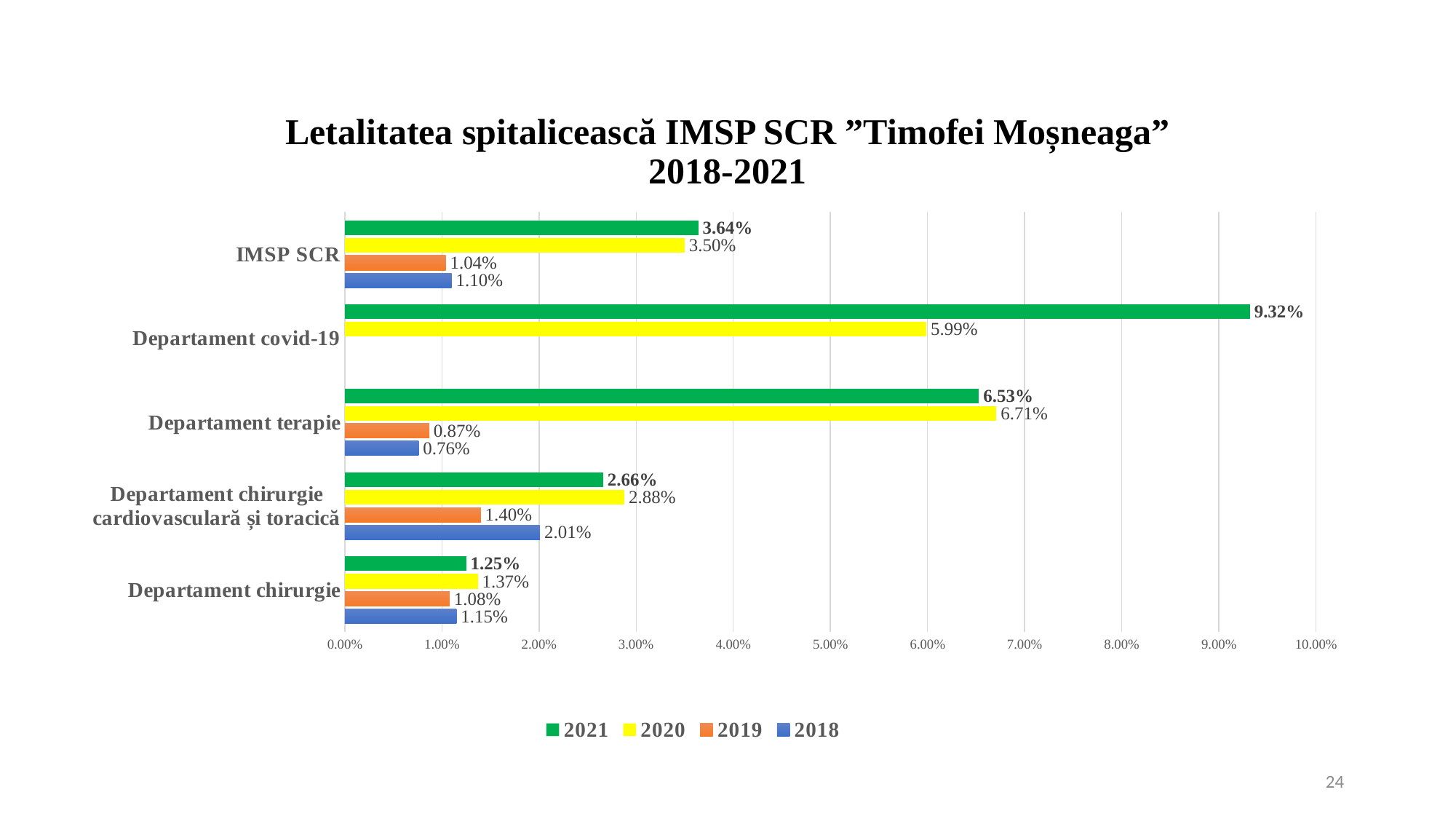
What is the value for Departament chirurgie cardiovasculară și toracică in 2019? 1.40% What is the difference between the 2021 and 2020 values for Departament covid-19? 3.33% What is the value for Departament covid-19 in 2021? 9.32% Which category has the highest value in the 2021 series? Departament covid-19 How many series does the legend list? 4 What kind of chart is shown on the slide? Bar chart Which category has the lowest value in the 2018 series? Departament terapie What is the value for Departament terapie in 2020? 6.71% How many categories are shown on the chart? 5 Which is larger for Departament chirurgie: the 2020 value or the 2021 value? 2020 What is the value for IMSP SCR in 2018? 1.10% Which colour represents the 2019 series in the legend? Orange